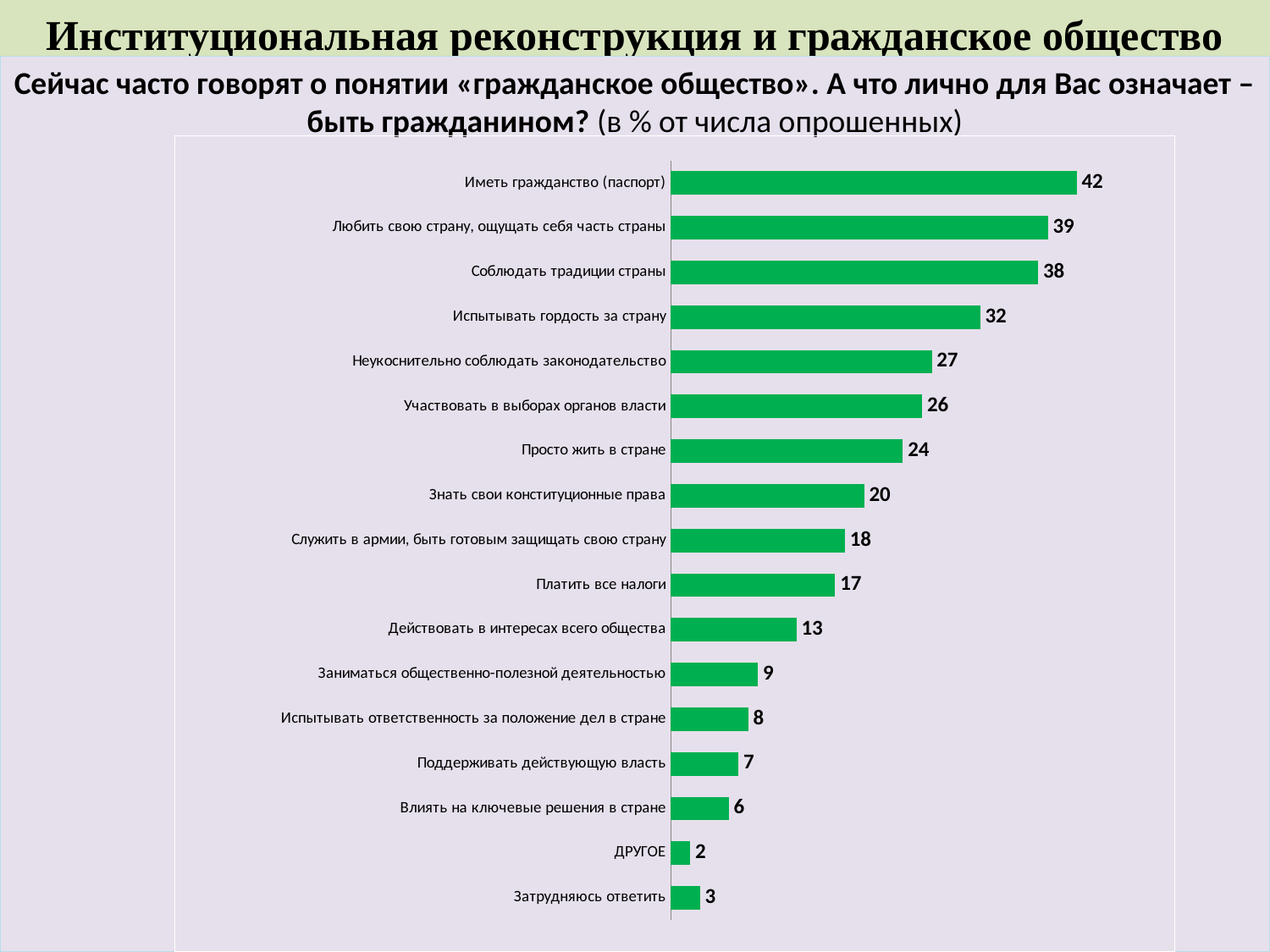
What colour are the bars in the chart? Green What is the value for «Платить все налоги»? 17 Which category has the highest value? Иметь гражданство (паспорт) What is the value for «Иметь гражданство (паспорт)»? 42 Which category has the lowest value? ДРУГОЕ How many categories are shown in the chart? 17 What type of chart is shown on the slide? Bar chart What is the value for «Затрудняюсь ответить»? 3 Which is larger: the value for «Служить в армии, быть готовым защищать свою страну» or for «Действовать в интересах всего общества»? Служить в армии, быть готовым защищать свою страну What is the difference between the values for «Иметь гражданство (паспорт)» and «Любить свою страну, ощущать себя часть страны»? 3 What is the value for «Знать свои конституционные права»? 20 What is the difference between the values for «Испытывать гордость за страну» and «Просто жить в стране»? 8